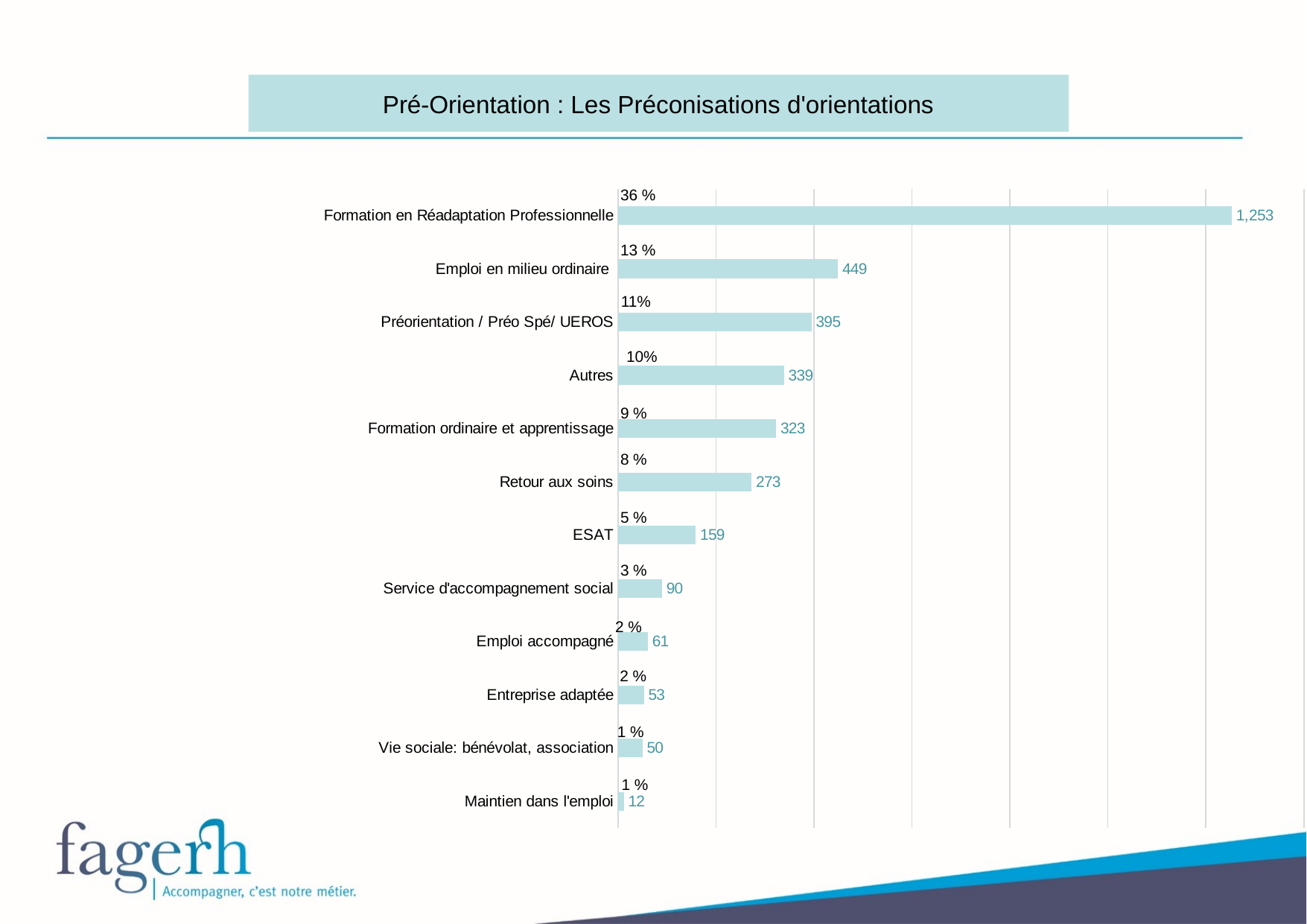
Which category has the lowest value? Maintien dans l'emploi Which is larger, the value for Autres or the value for Formation ordinaire et apprentissage? Autres What kind of chart is shown on the slide? Bar chart What is the value for Emploi en milieu ordinaire? 449 What is the value for Formation en Réadaptation Professionnelle? 1,253 What is the difference between the values for Emploi en milieu ordinaire and Préorientation / Préo Spé/ UEROS? 54 What percentage is shown for ESAT? 5 % What is the value for Retour aux soins? 273 What is the difference between the values for Emploi accompagné and Entreprise adaptée? 8 How many categories does the chart show? 12 What is the title of the slide? Pré-Orientation : Les Préconisations d'orientations Which category has the highest value? Formation en Réadaptation Professionnelle